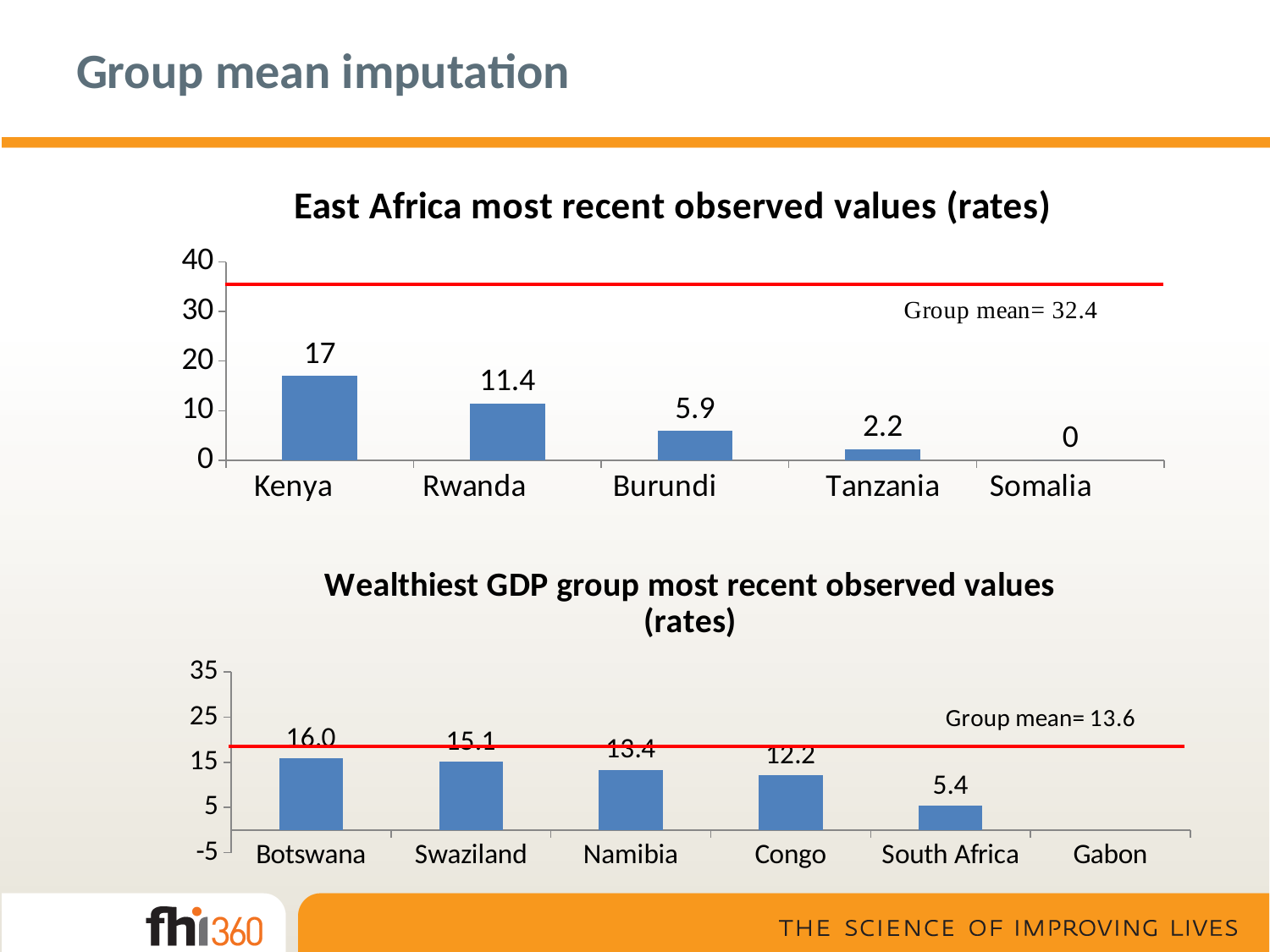
In the 'Wealthiest GDP group most recent observed values (rates)' chart, what is the difference between the values for Botswana and Congo? 3.8 In the 'East Africa most recent observed values (rates)' chart, what is the value for Burundi? 5.9 In the 'Wealthiest GDP group most recent observed values (rates)' chart, what group mean is stated? 13.6 In the 'East Africa most recent observed values (rates)' chart, what group mean is stated? 32.4 In the 'Wealthiest GDP group most recent observed values (rates)' chart, what is the value for South Africa? 5.4 What type of chart is the 'Wealthiest GDP group most recent observed values (rates)' chart? Bar chart In the 'Wealthiest GDP group most recent observed values (rates)' chart, what is the value for Swaziland? 15.1 In the 'East Africa most recent observed values (rates)' chart, what is the value for Kenya? 17 In the 'Wealthiest GDP group most recent observed values (rates)' chart, which of Namibia or Congo has the larger value? Namibia In the 'East Africa most recent observed values (rates)' chart, what is the difference between the values for Kenya and Rwanda? 5.6 In the 'East Africa most recent observed values (rates)' chart, which country has the highest value? Kenya How many countries are shown on the x axis of the 'East Africa most recent observed values (rates)' chart? 5